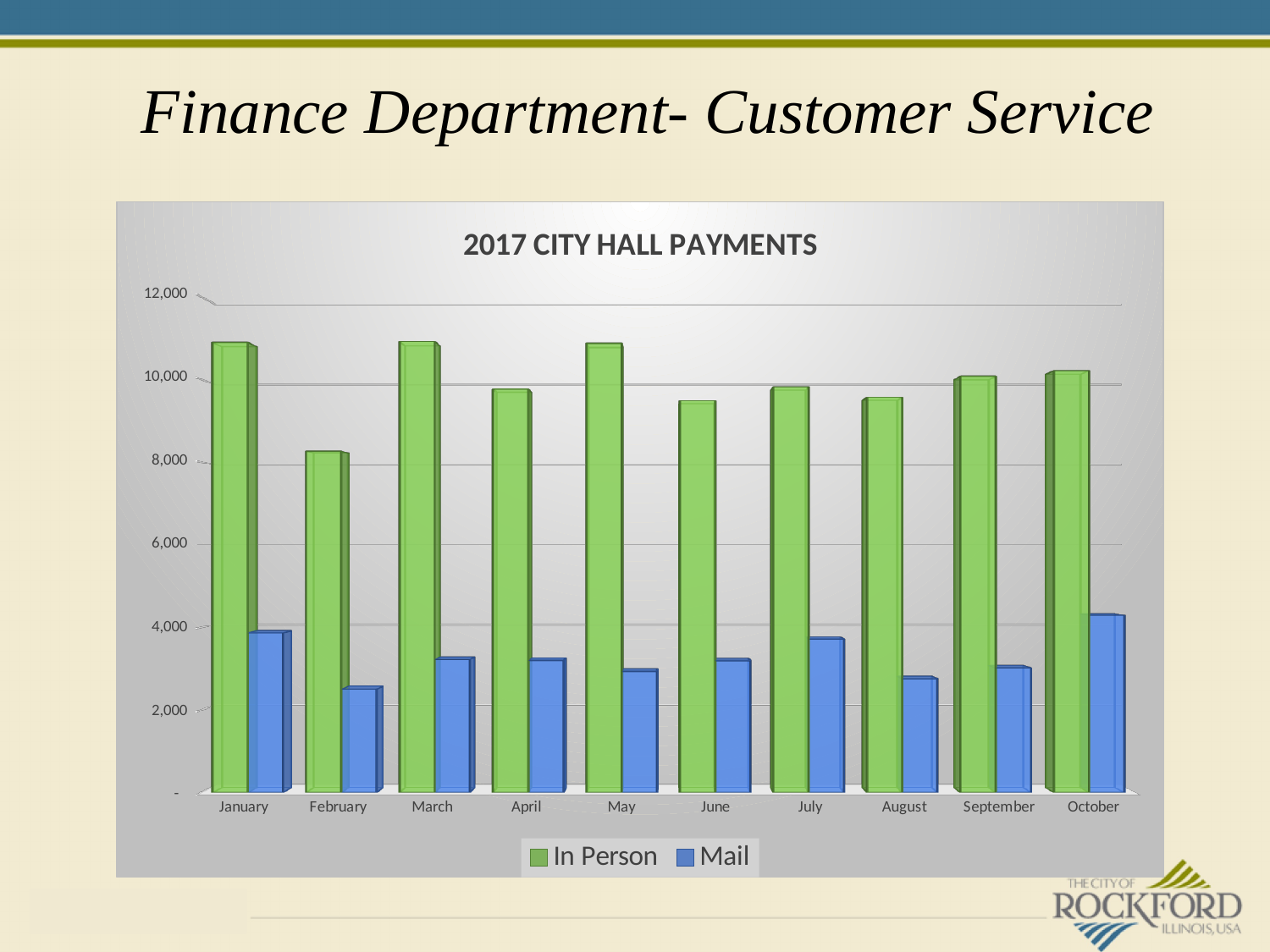
What is the title of the chart? 2017 CITY HALL PAYMENTS Which colour represents the Mail series? Blue Which month has the highest Mail value? October Is the Mail value for October greater or less than 4,000? greater Is the In Person value for February greater or less than 10,000? less What kind of chart is shown on the slide? Bar chart Is the In Person value for April greater or less than 10,000? less Which month has the lowest In Person value? February How many series does the legend list? 2 Which is larger, the Mail value for July or the Mail value for May? July Which month has the lowest Mail value? February How many months are shown on the x axis? 10